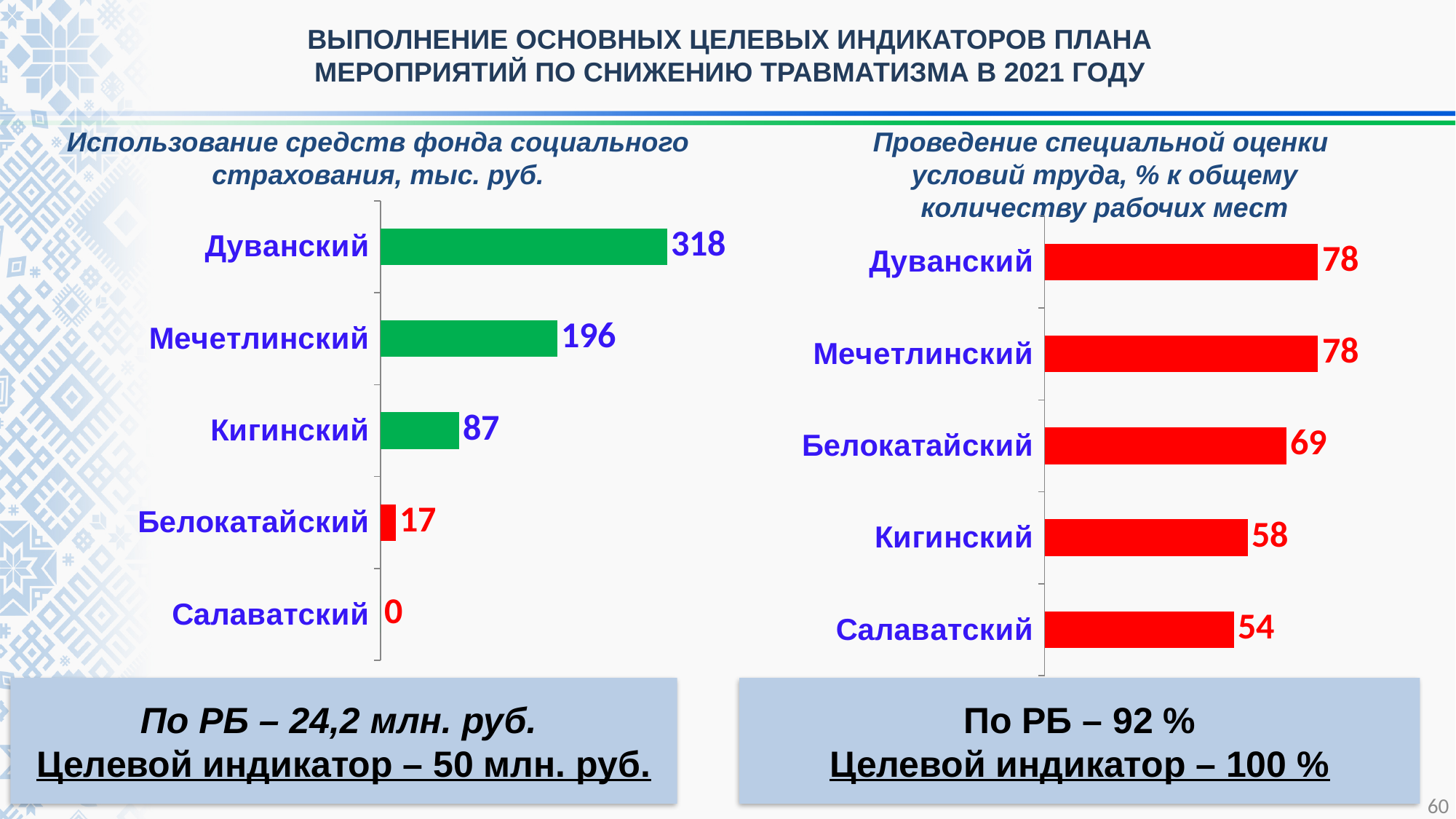
In the left chart (Использование средств фонда социального страхования), how many districts are shown? 5 In the right chart (Проведение специальной оценки условий труда), what is the value for Белокатайский? 69 In the left chart (Использование средств фонда социального страхования), which district has the lowest value? Салаватский In the left chart (Использование средств фонда социального страхования), which is larger: Мечетлинский or Белокатайский? Мечетлинский In the right chart (Проведение специальной оценки условий труда), what is the difference between Дуванский and Кигинский? 20 In the left chart (Использование средств фонда социального страхования), what is the difference between Дуванский and Мечетлинский? 122 In the right chart (Проведение специальной оценки условий труда), what is the value for Салаватский? 54 What type of chart is the right chart (Проведение специальной оценки условий труда)? Bar chart In the left chart (Использование средств фонда социального страхования), what is the value for Дуванский? 318 In the left chart (Использование средств фонда социального страхования), what is the value for Кигинский? 87 In the left chart (Использование средств фонда социального страхования), what colour is the bar for Белокатайский? Red In the right chart (Проведение специальной оценки условий труда), which district has the lowest value? Салаватский